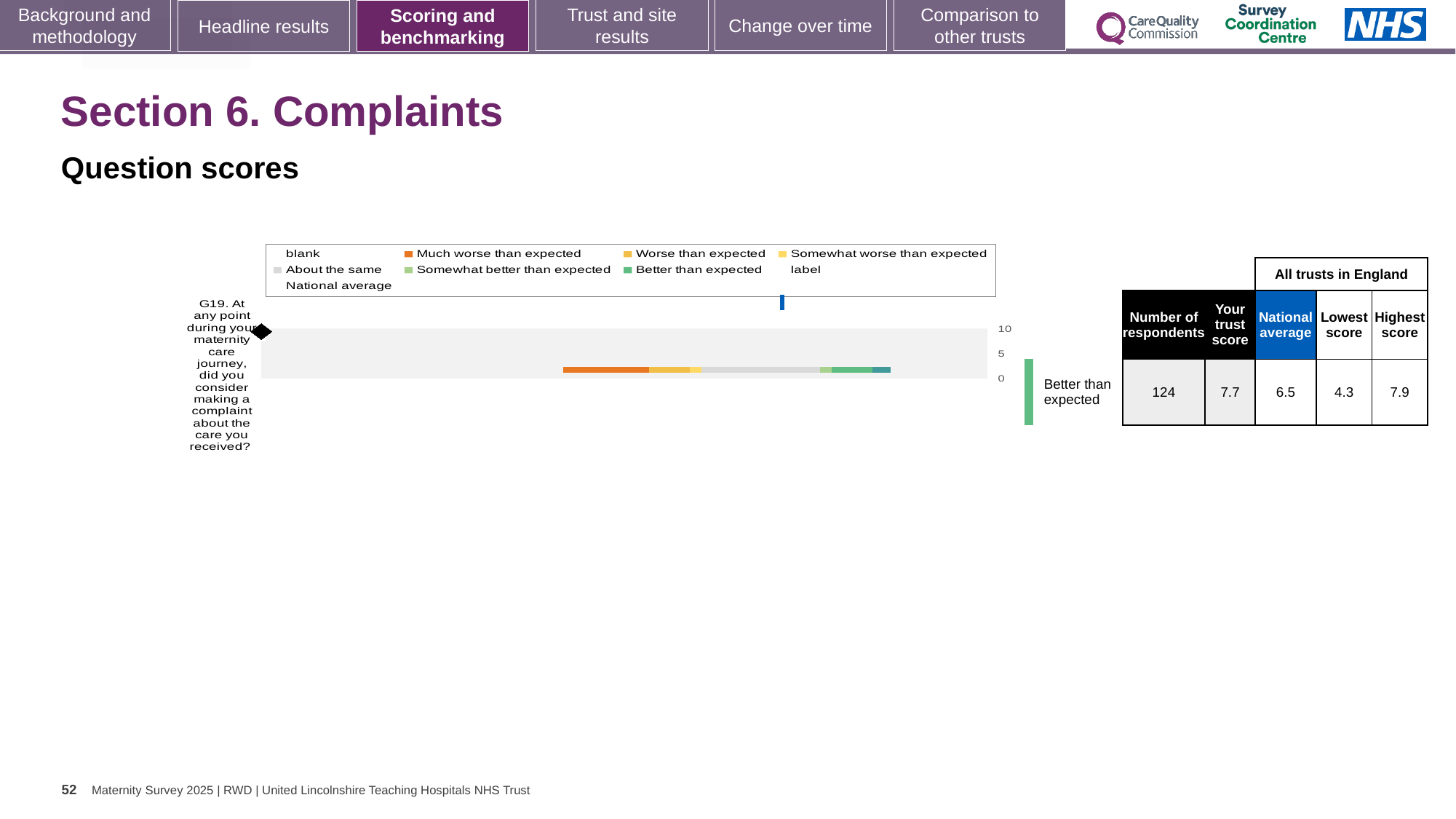
What kind of chart is shown on the slide? bar chart What is the national average for question G19 shown in the table? 6.5 What is the difference between the trust score and the national average for question G19? 1.2 How many respondents answered question G19? 124 What is the trust score for question G19 shown in the table? 7.7 What is the difference between the highest and lowest scores among all trusts in England for question G19? 3.6 What is the lowest score among all trusts in England for question G19? 4.3 Which is larger for question G19, the trust score or the national average? trust score What is the highest score among all trusts in England for question G19? 7.9 Which question is plotted in the chart? G19. At any point during your maternity care journey, did you consider making a complaint about the care you received? What benchmark category is shown next to the chart for question G19? Better than expected How many questions (categories) are plotted in the chart? 1